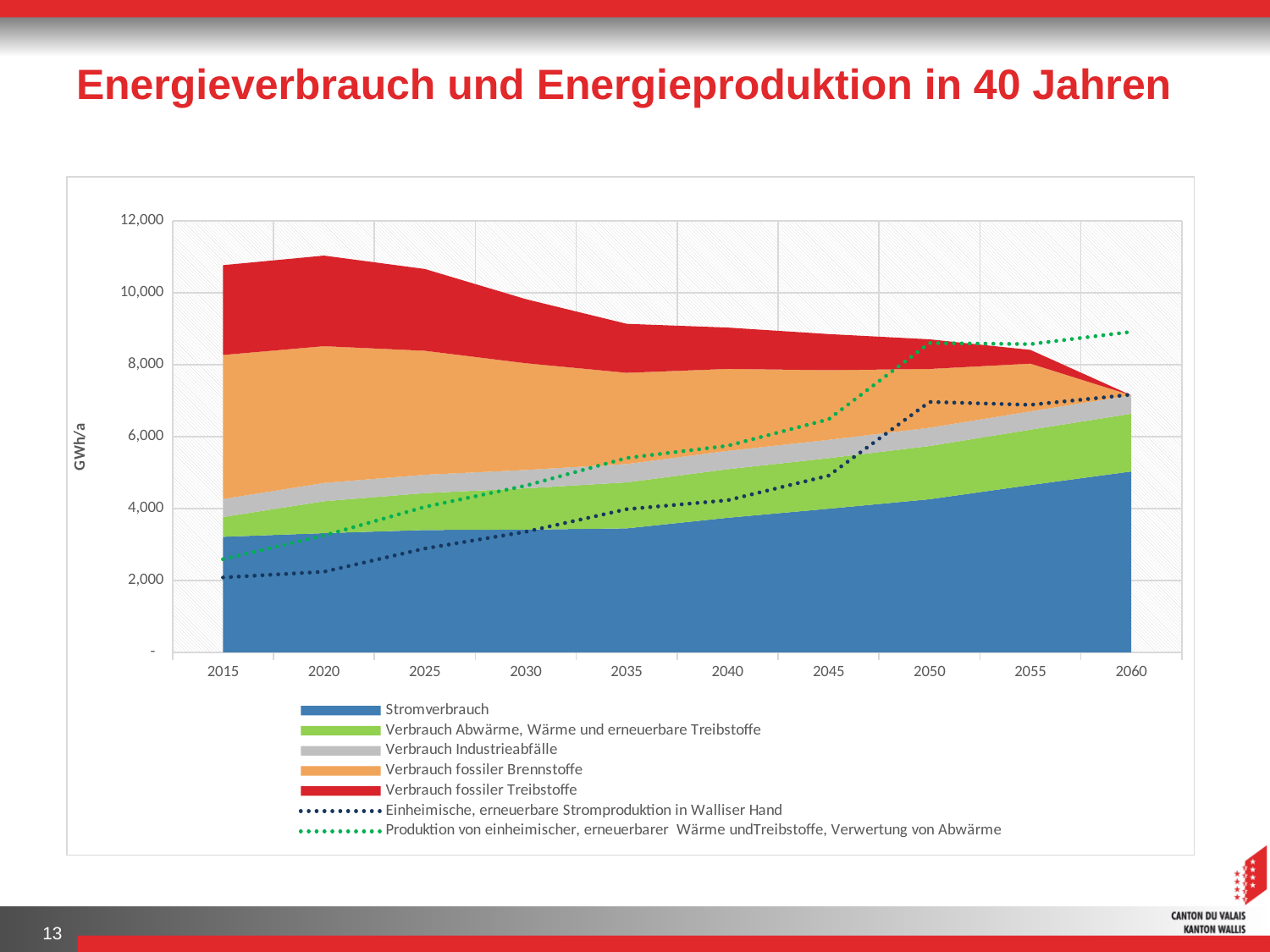
Is the value for Stromverbrauch in 2060 greater or less than 4,000? greater Does Stromverbrauch rise or fall from 2015 to 2060? rise Is the total stacked consumption in 2015 greater or less than 10,000? greater How many years are labelled on the x axis? 10 How many series does the legend list? 7 Is the value for Stromverbrauch in 2015 greater or less than 4,000? less What unit is shown on the y axis? GWh/a What is the title of the slide's chart? Energieverbrauch und Energieproduktion in 40 Jahren What kind of chart is shown on the slide? combination area and line chart In 2060, which is larger: 'Einheimische, erneuerbare Stromproduktion in Walliser Hand' or 'Produktion von einheimischer, erneuerbarer Wärme undTreibstoffe, Verwertung von Abwärme'? Produktion von einheimischer, erneuerbarer Wärme undTreibstoffe, Verwertung von Abwärme